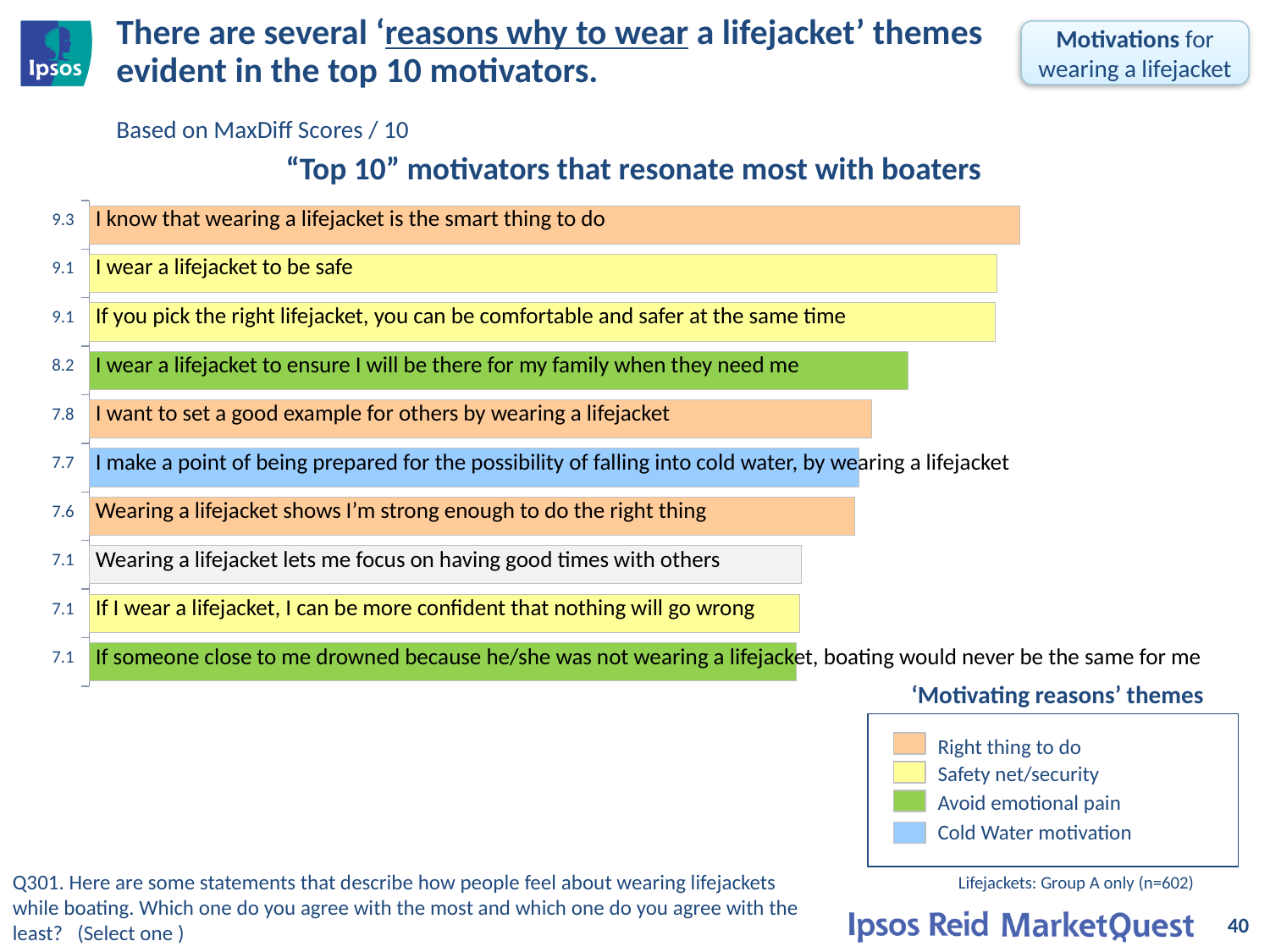
What is the difference between the MaxDiff scores for "I know that wearing a lifejacket is the smart thing to do" and "I wear a lifejacket to be safe"? 0.2 What type of chart is used to show the top 10 motivators? Bar chart What is the difference between the MaxDiff scores for "I wear a lifejacket to ensure I will be there for my family when they need me" and "I want to set a good example for others by wearing a lifejacket"? 0.4 Which has a higher MaxDiff score: "I want to set a good example for others by wearing a lifejacket" or "Wearing a lifejacket shows I'm strong enough to do the right thing"? I want to set a good example for others by wearing a lifejacket Which theme does the legend associate with the green bars? Avoid emotional pain What is the MaxDiff score for "I wear a lifejacket to ensure I will be there for my family when they need me"? 8.2 How many 'Motivating reasons' themes are listed in the legend? 4 Do the MaxDiff scores increase or decrease from the top bar to the bottom bar? Decrease What is the MaxDiff score for "I know that wearing a lifejacket is the smart thing to do"? 9.3 What is the MaxDiff score for "I make a point of being prepared for the possibility of falling into cold water, by wearing a lifejacket"? 7.7 Which motivator has the highest MaxDiff score? I know that wearing a lifejacket is the smart thing to do How many motivators are shown in the chart? 10